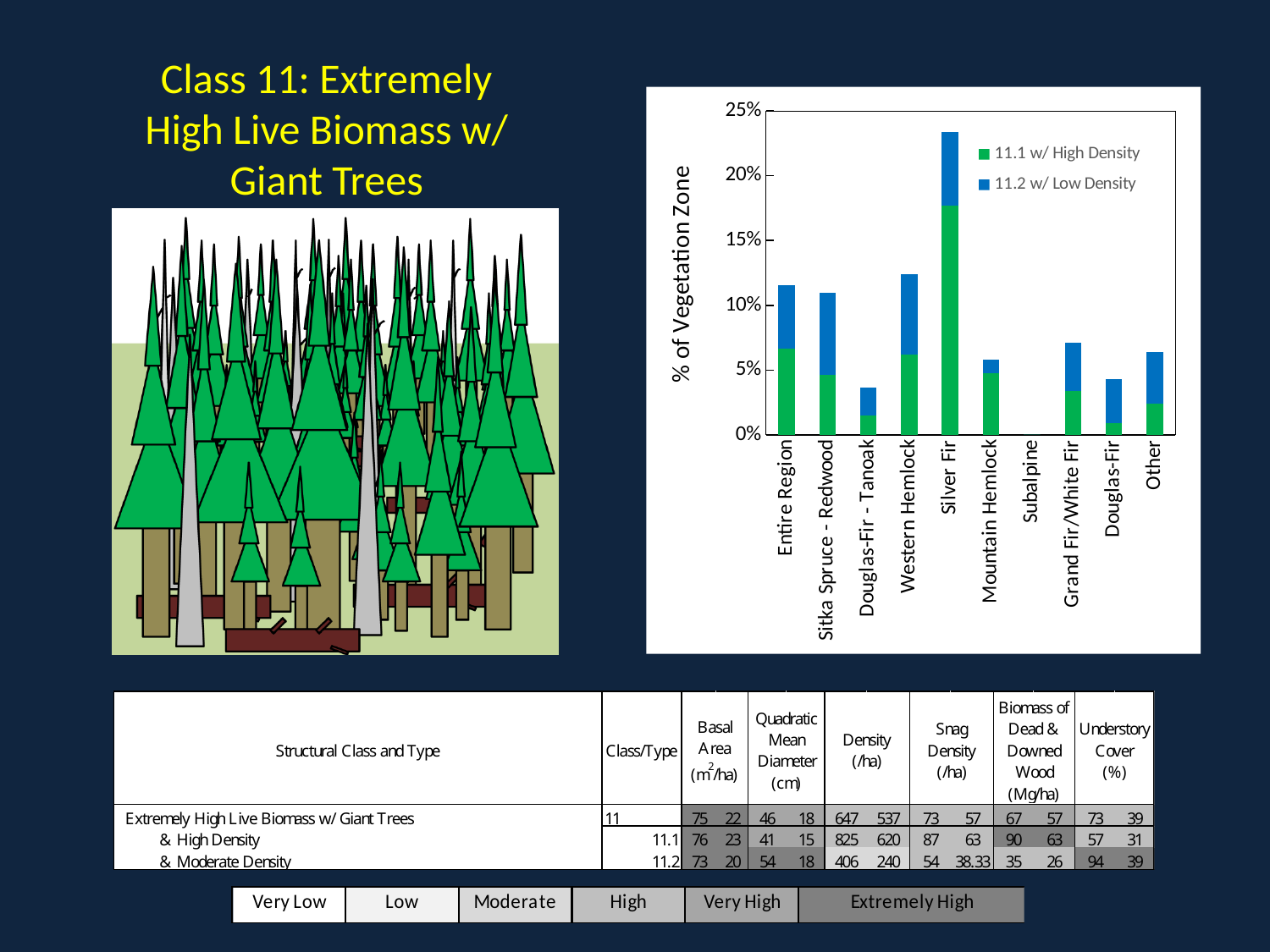
Is the total value for Grand Fir/White Fir greater or less than 10%? less How many vegetation zone categories are shown on the x axis of the chart? 10 Is the total value for Western Hemlock greater or less than 10%? greater What kind of chart is shown on the slide? stacked bar chart Which vegetation zone has the lowest total in the chart? Subalpine Which vegetation zone has the highest total bar in the chart? Silver Fir Is the total value for Silver Fir greater or less than 20%? greater How many series does the chart legend list? 2 What is the label on the y axis of the chart? % of Vegetation Zone Which has a larger total bar, Sitka Spruce - Redwood or Grand Fir/White Fir? Sitka Spruce - Redwood Which has a larger total bar, Silver Fir or Western Hemlock? Silver Fir